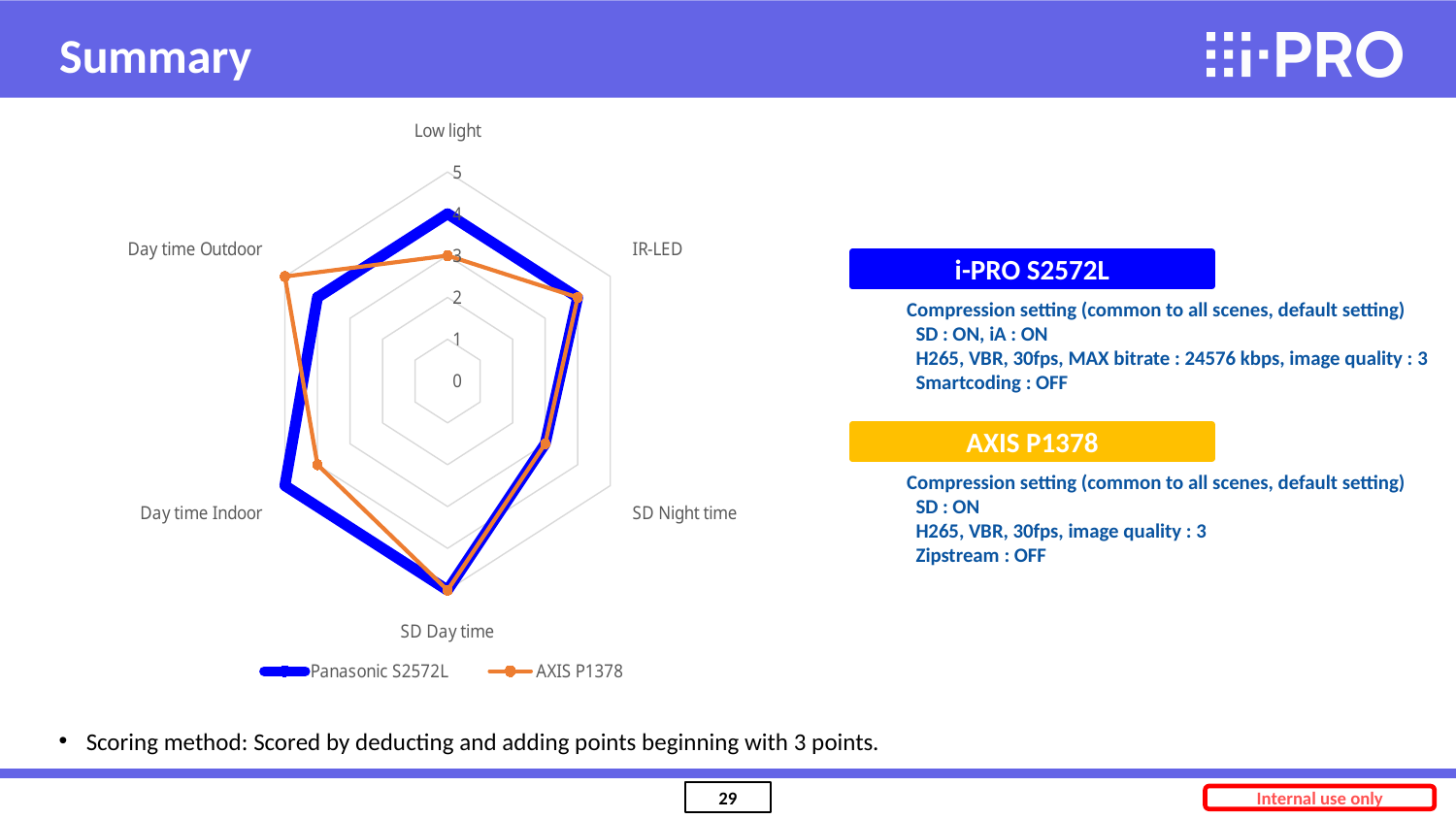
What kind of chart is shown on the slide? Radar chart What are the two series named in the chart's legend? Panasonic S2572L and AXIS P1378 Is the Day time Indoor value for Panasonic S2572L greater or less than 4? greater How many series does the chart's legend list? 2 What is the Low light score for AXIS P1378? 3 Is the Day time Outdoor value for AXIS P1378 greater or less than 4? greater What colour is the line for Panasonic S2572L in the chart? Blue Which series has the higher value for Day time Indoor? Panasonic S2572L How many categories (axes) does the radar chart have? 6 Which series has the higher value for Day time Outdoor? AXIS P1378 What is the Low light score for Panasonic S2572L? 4